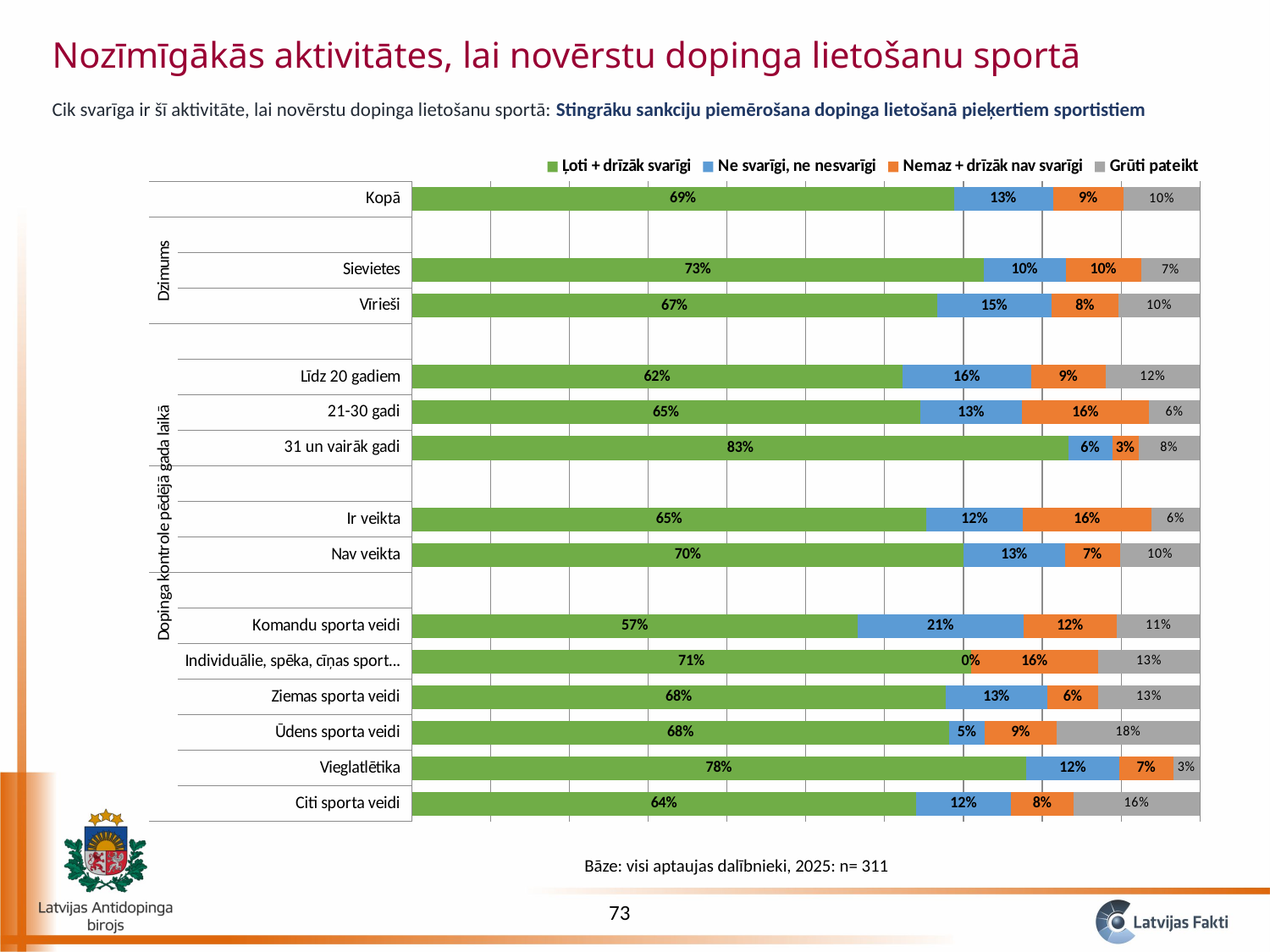
What is the base (n) stated below the chart? n= 311 Which category has the lowest value for "Ļoti + drīzāk svarīgi"? Komandu sporta veidi Which has a larger "Ļoti + drīzāk svarīgi" value, Vieglatlētika or Citi sporta veidi? Vieglatlētika Which category has the highest value for "Ne svarīgi, ne nesvarīgi"? Komandu sporta veidi What is the value of "Ļoti + drīzāk svarīgi" for Kopā? 69% What is the value of "Nemaz + drīzāk nav svarīgi" for 21-30 gadi? 16% What is the value of "Ne svarīgi, ne nesvarīgi" for Individuālie, spēka, cīņas sport...? 0% What kind of chart is shown on the slide? Stacked bar chart What is the value of "Grūti pateikt" for Ūdens sporta veidi? 18% What is the difference in "Ļoti + drīzāk svarīgi" between Sievietes and Vīrieši? 6 percentage points Which category has the highest value for "Ļoti + drīzāk svarīgi"? 31 un vairāk gadi How many series does the legend list? 4